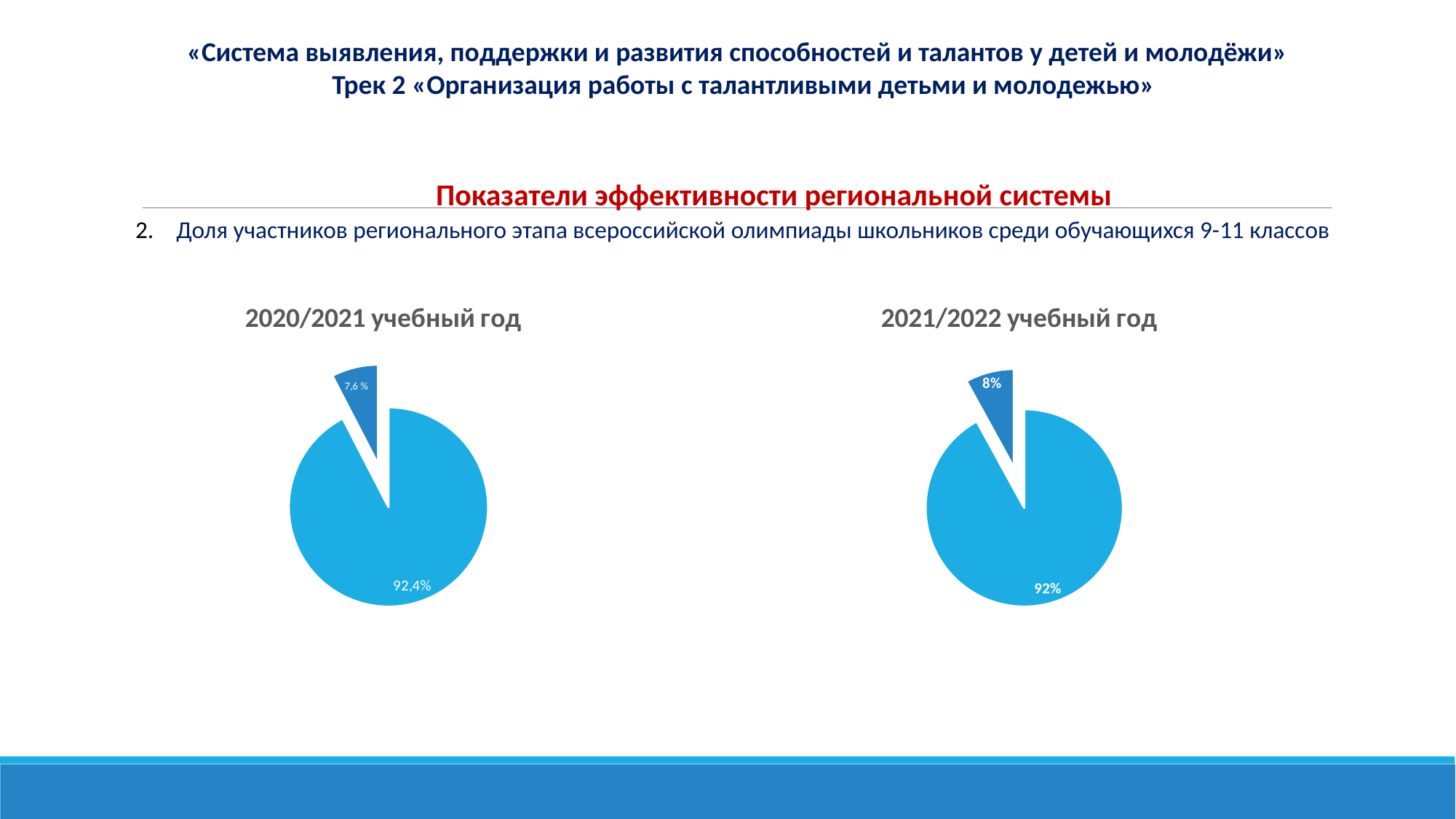
In the "2020/2021 учебный год" chart, what value is printed on the large slice? 92,4% What kind of chart is shown under the title "2021/2022 учебный год"? pie chart In the "2021/2022 учебный год" chart, what value is printed on the small exploded slice? 8% In the "2020/2021 учебный год" chart, what value is printed on the small exploded slice? 7,6 % Which chart has the larger small exploded slice, "2020/2021 учебный год" or "2021/2022 учебный год"? 2021/2022 учебный год How many slices does the "2020/2021 учебный год" pie chart have? 2 How many slices does the "2021/2022 учебный год" pie chart have? 2 What kind of chart is shown under the title "2020/2021 учебный год"? pie chart In the "2020/2021 учебный год" chart, what is the difference between the large slice and the small slice? 84,8% What is the title of the pie chart on the left side of the slide? 2020/2021 учебный год In the "2021/2022 учебный год" chart, what is the difference between the large slice and the small slice? 84% In the "2021/2022 учебный год" chart, what value is printed on the large slice? 92%